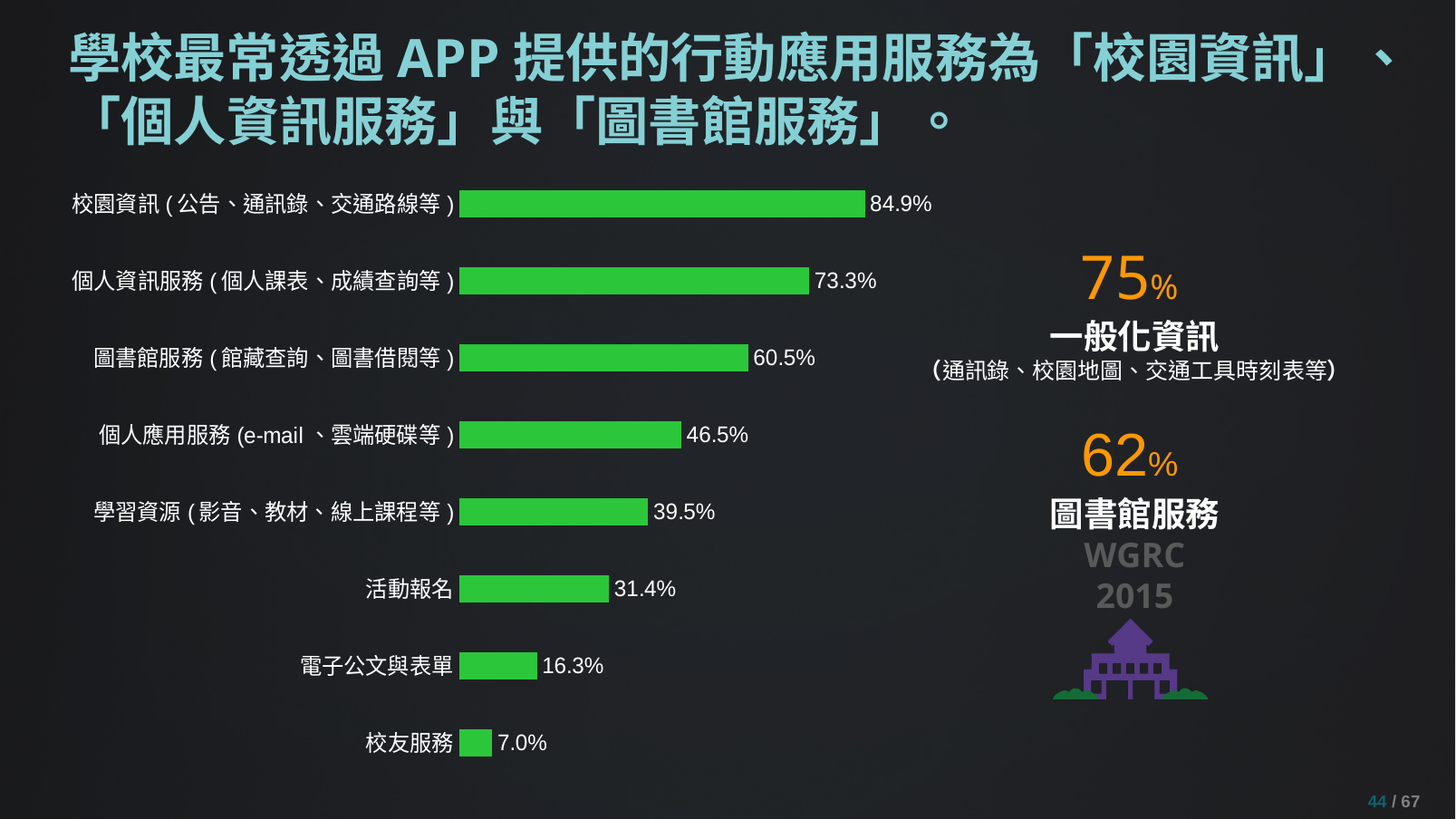
What is the difference between the values for 個人資訊服務 and 個人應用服務? 26.8% What is the value for 圖書館服務 (館藏查詢、圖書借閱等)? 60.5% What is the value for 校友服務? 7.0% Which category has the lowest value? 校友服務 What kind of chart is shown on the slide? Bar chart What is the difference between the values for 學習資源 and 電子公文與表單? 23.2% How many categories are shown in the bar chart? 8 What colour are the bars in the chart? Green Which is larger, the value for 學習資源 or the value for 活動報名? 學習資源 What is the value for 校園資訊 (公告、通訊錄、交通路線等)? 84.9% What is the value for 活動報名? 31.4% Which category has the highest value? 校園資訊 (公告、通訊錄、交通路線等)